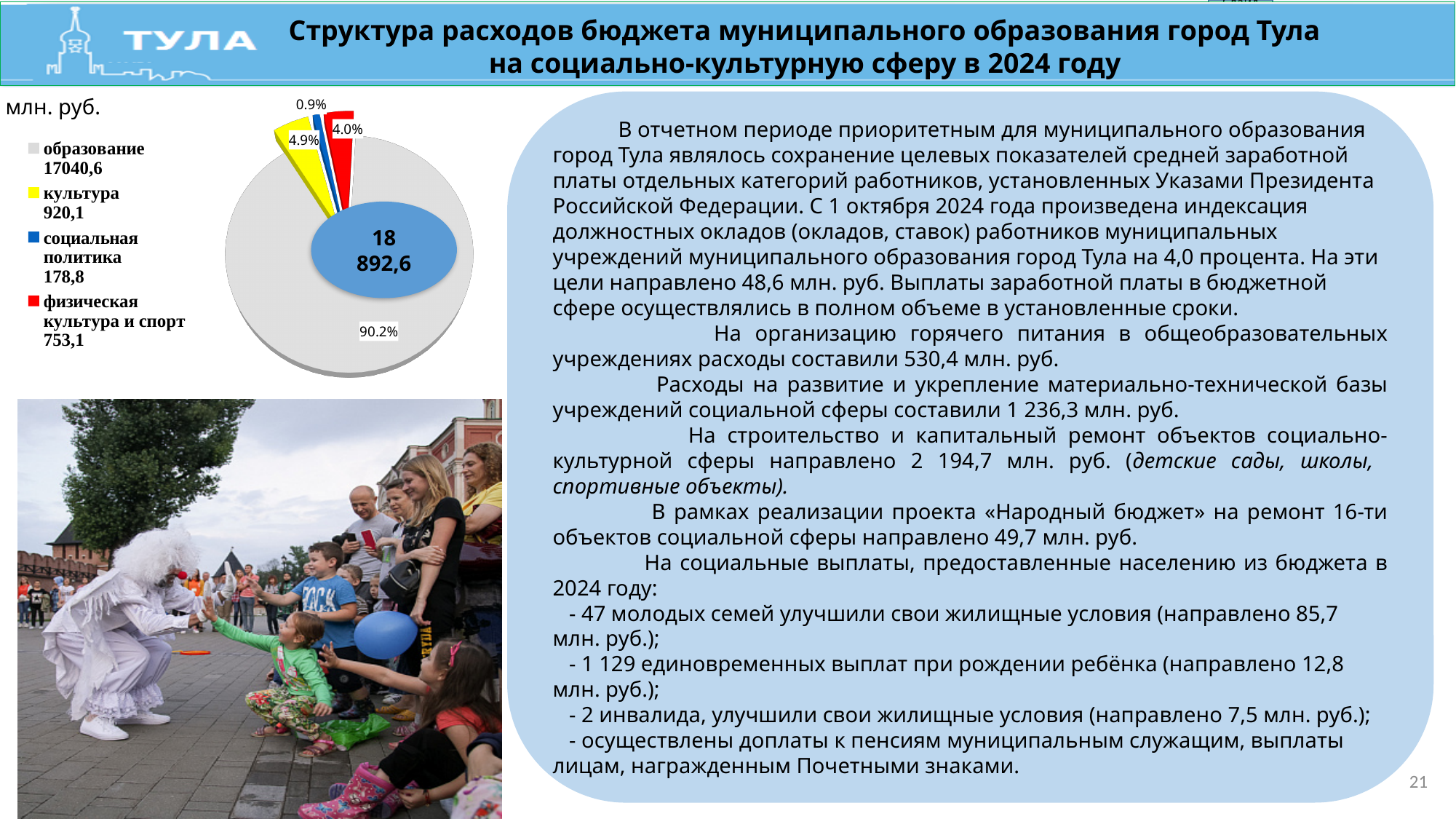
What kind of chart is shown on the slide? pie chart What value is shown in the legend for физическая культура и спорт? 753,1 How many categories does the pie chart's legend list? 4 What value is shown in the legend for образование? 17040,6 Which category has the smallest slice of the pie? социальная политика What value is shown in the legend for культура? 920,1 What total value is printed in the centre of the pie chart? 18 892,6 What percentage share of the pie does культура have? 4.9% What percentage share of the pie does образование have? 90.2% What value is shown in the legend for социальная политика? 178,8 Which category has the largest slice of the pie? образование Which is larger, the value for культура or the value for физическая культура и спорт? культура